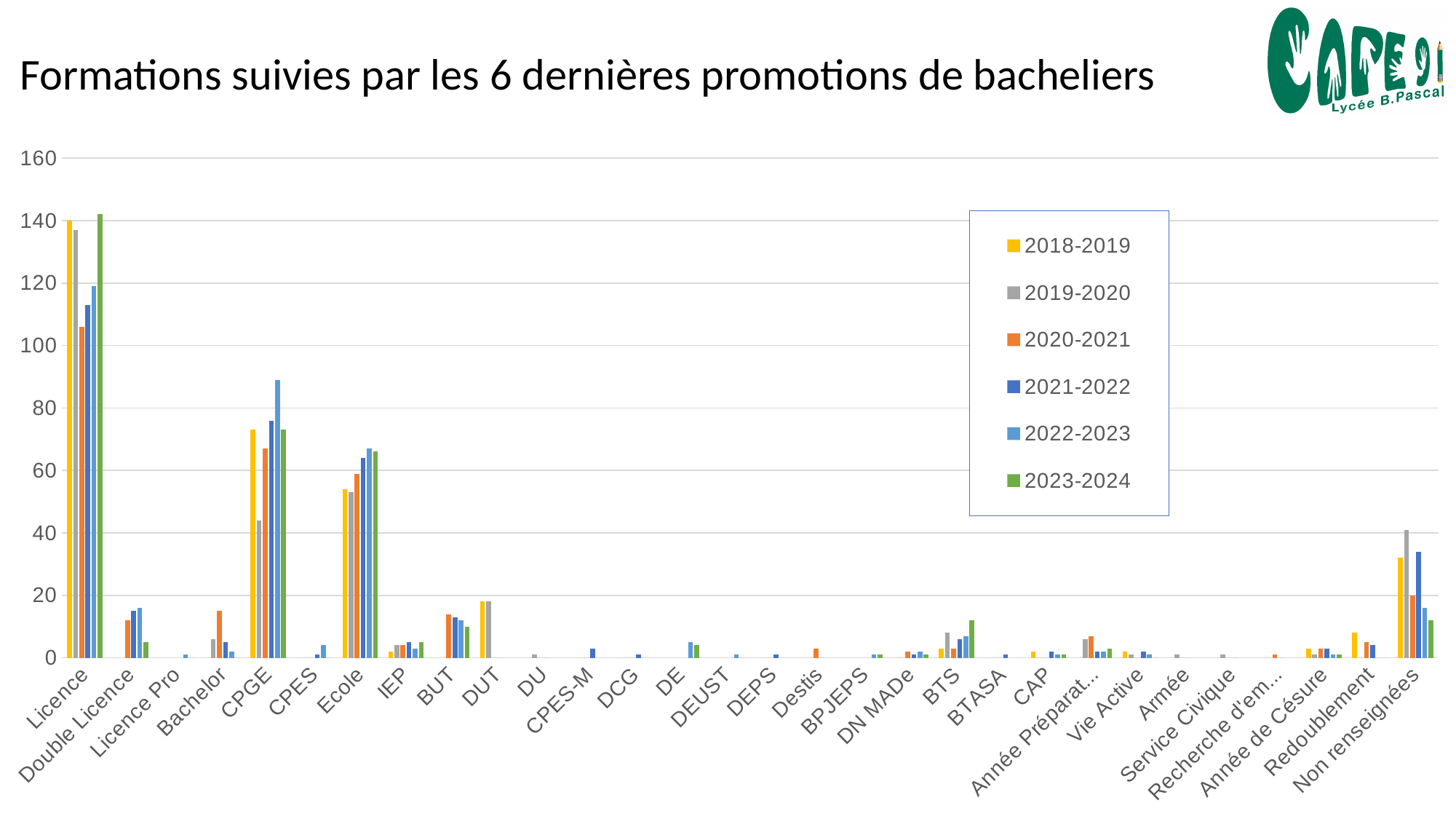
What is the title of the chart? Formations suivies par les 6 dernières promotions de bacheliers What kind of chart is shown on the slide? bar chart For 2018-2019, which is larger: CPGE or Ecole? CPGE How many series does the legend list? 6 Is the value for CPGE in 2022-2023 greater or less than 80? greater Within the Non renseignées category, which series has the highest bar? 2019-2020 How many categories are shown along the x axis? 30 Which category has the highest bars overall? Licence Within the CPGE category, which series has the highest bar? 2022-2023 Is the value for Licence in 2020-2021 greater or less than 100? greater